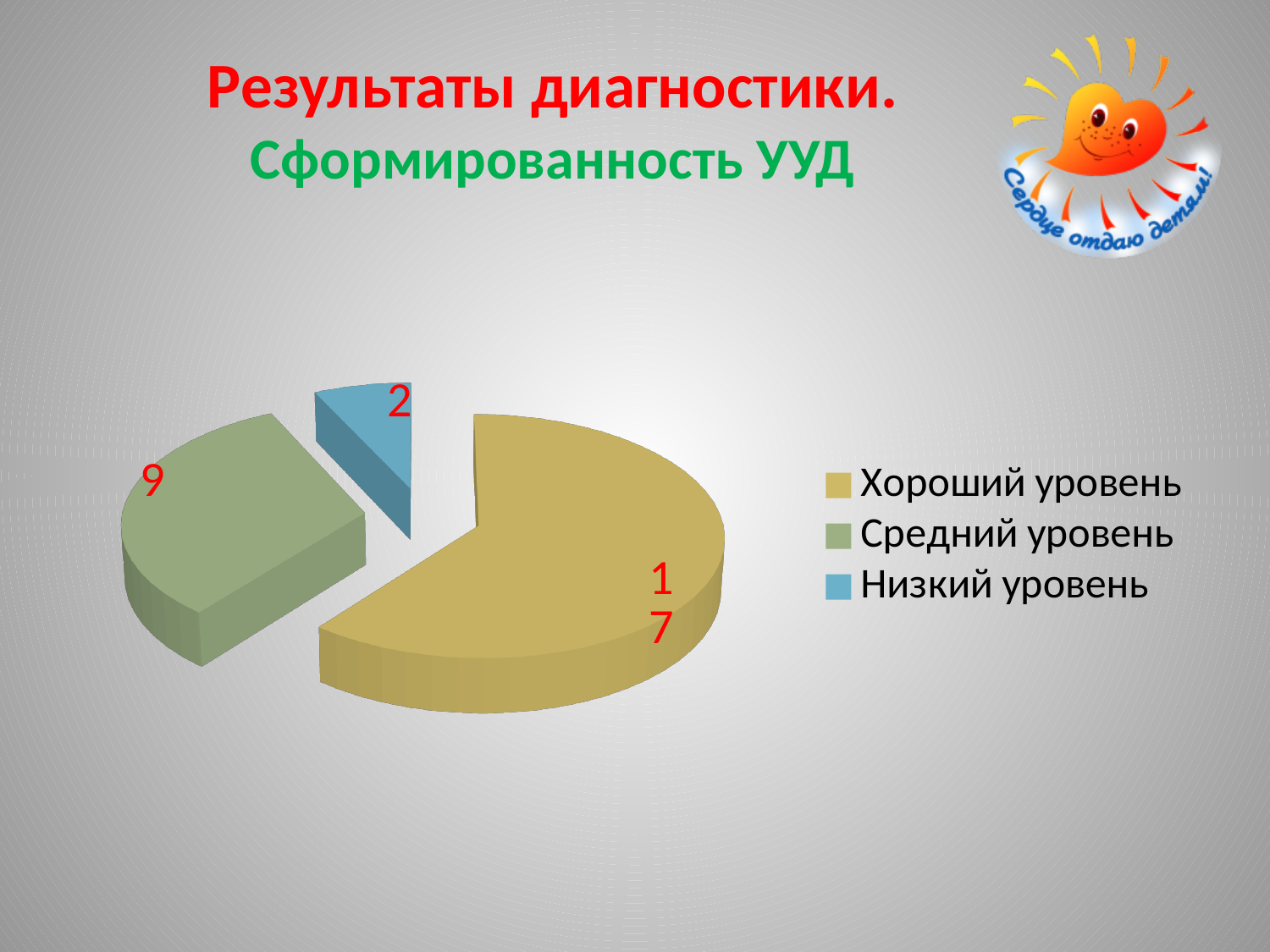
What is the value for Низкий уровень? 2 Which category has the smallest slice of the pie? Низкий уровень Which category has the largest slice of the pie? Хороший уровень How many slices does the pie chart have? 3 What is the total of all the slices in the pie chart? 28 What colour is the slice for Низкий уровень? Blue What is the difference between the values for Средний уровень and Низкий уровень? 7 Which is larger, the value for Средний уровень or the value for Низкий уровень? Средний уровень What is the value for Хороший уровень? 17 What is the difference between the values for Хороший уровень and Средний уровень? 8 What is the value for Средний уровень? 9 What type of chart is shown on the slide? Pie chart